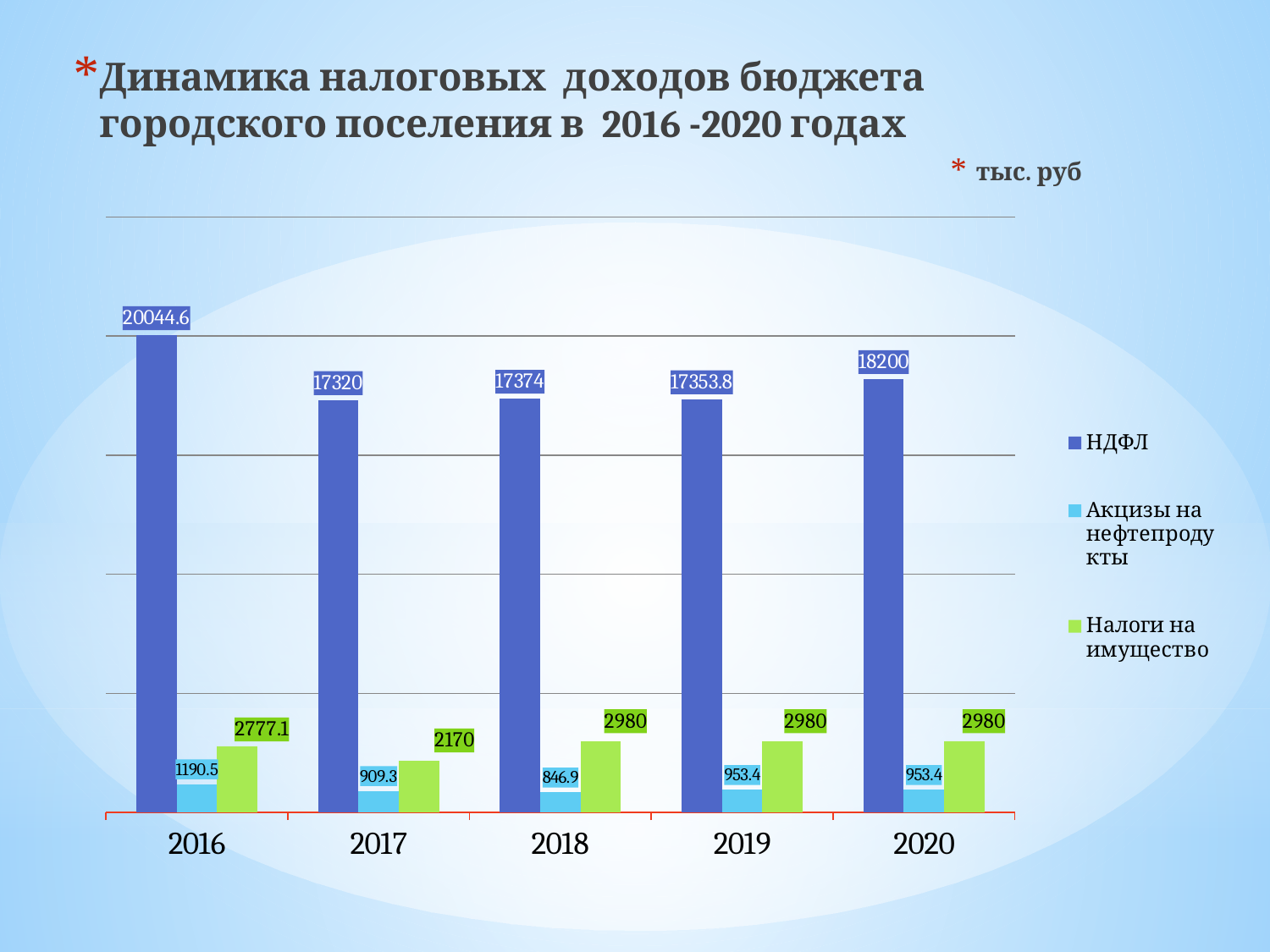
What is the difference between НДФЛ in 2016 and НДФЛ in 2020? 1844.6 How many years are shown on the x axis? 5 In which year is НДФЛ highest? 2016 Which is larger: Налоги на имущество in 2016 or Налоги на имущество in 2017? 2016 What is the value of Налоги на имущество for 2017? 2170 What is the value of НДФЛ for 2020? 18200 What kind of chart is shown on the slide? bar chart What is the value of Акцизы на нефтепродукты for 2018? 846.9 What is the value of НДФЛ for 2016? 20044.6 What unit is stated for the values on the slide? тыс. руб In which year is Акцизы на нефтепродукты lowest? 2018 How many series does the legend list? 3